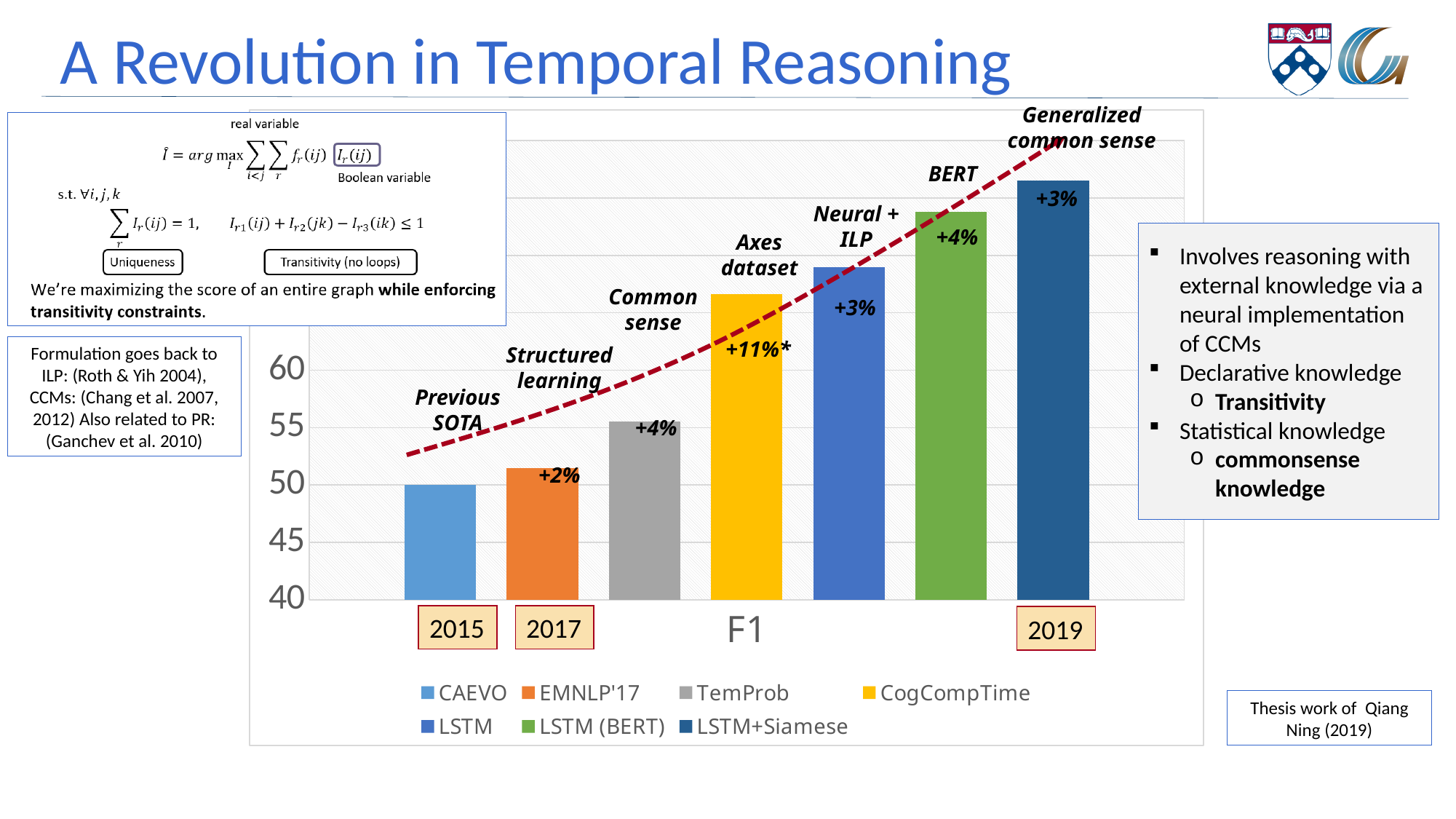
Which is larger, the bar for CogCompTime or the bar for TemProb? CogCompTime Is the value for TemProb greater or less than 60? less Do the bar values rise or fall from left to right across the chart? rise How many series does the chart legend list? 7 Is the value for EMNLP'17 greater or less than 50? greater What kind of chart is shown on the slide? bar chart How many bars are plotted in the chart? 7 Which series has the highest bar in the chart? LSTM+Siamese What is the F1 value for CAEVO? 50 Is the value for CogCompTime greater or less than 60? greater What label is shown on the category axis beneath the bars? F1 Which series has the lowest bar in the chart? CAEVO